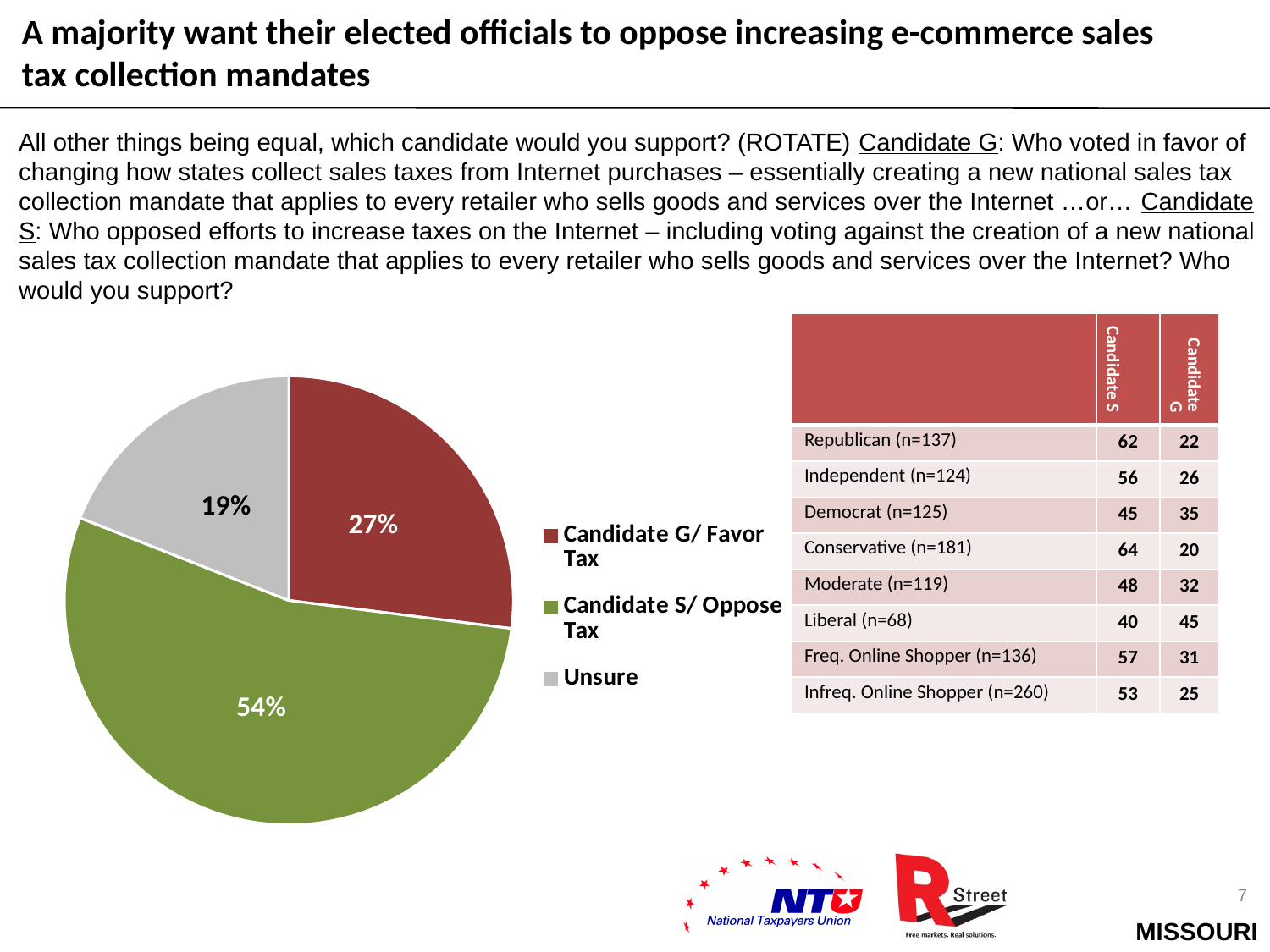
What percentage of respondents chose Candidate G/ Favor Tax? 27% What is the difference in percentage points between Candidate S/ Oppose Tax and Candidate G/ Favor Tax? 27 What is the difference in percentage points between Candidate G/ Favor Tax and Unsure? 8 Which is larger, the share for Candidate G/ Favor Tax or the share for Unsure? Candidate G/ Favor Tax What colour is the Candidate S/ Oppose Tax slice? green What kind of chart is shown on the slide? pie chart Which category has the largest share of the pie? Candidate S/ Oppose Tax What colour is the Unsure slice? grey What percentage of respondents were Unsure? 19% Which category has the smallest share of the pie? Unsure What percentage of respondents chose Candidate S/ Oppose Tax? 54% How many slices does the pie chart have? 3